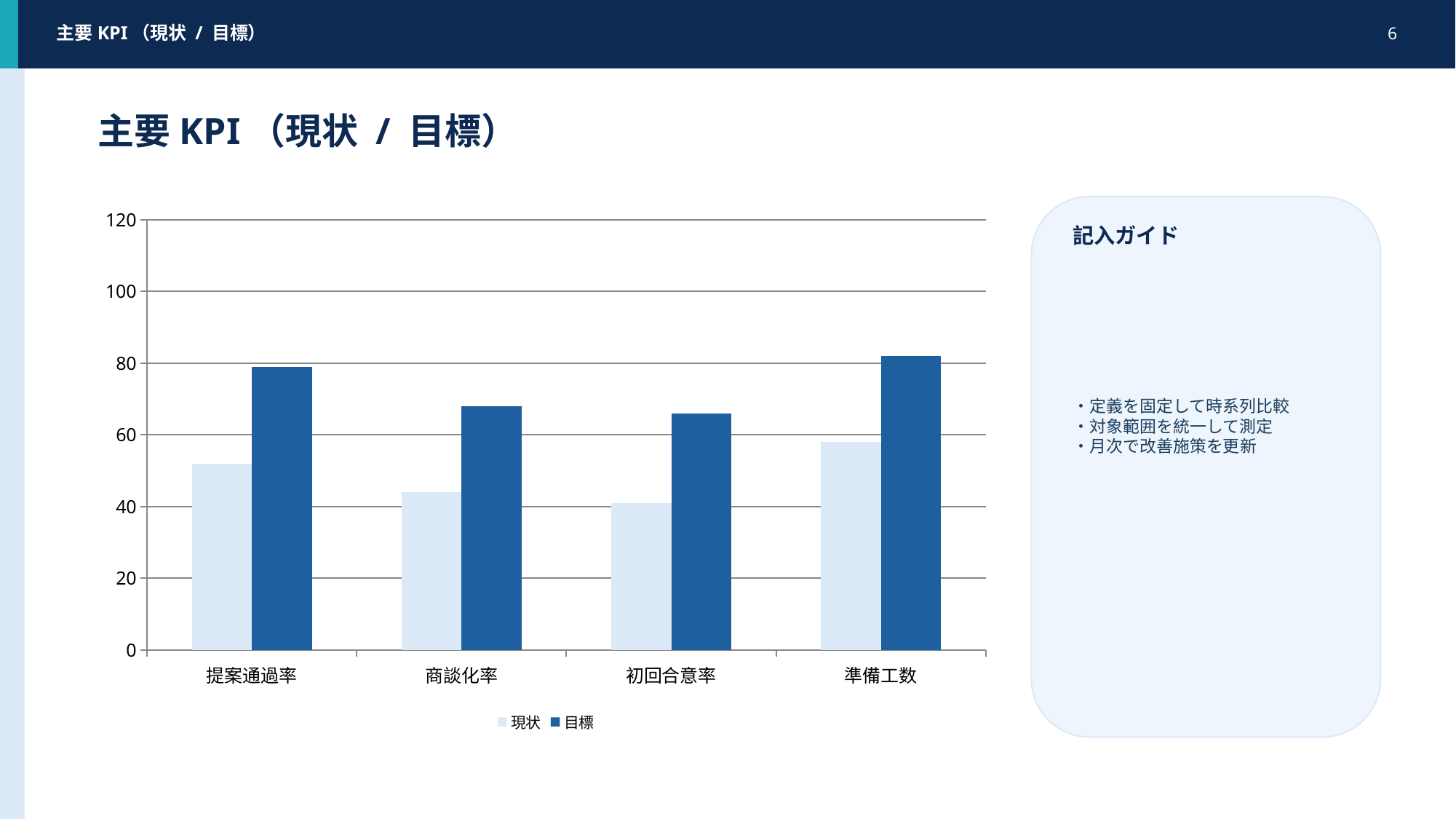
What are the two series named in the chart legend? 現状 and 目標 What kind of chart is shown on the slide? bar chart For 商談化率, which is larger: the 現状 value or the 目標 value? 目標 Which is larger: the 現状 value for 提案通過率 or the 現状 value for 商談化率? 提案通過率 Which category has the highest 現状 value? 準備工数 Is the 目標 value for 商談化率 greater or less than 60? greater How many series does the chart legend list? 2 Is the 現状 value for 初回合意率 greater or less than 60? less Is the 目標 value for 準備工数 greater or less than 60? greater How many categories are shown on the x axis of the chart? 4